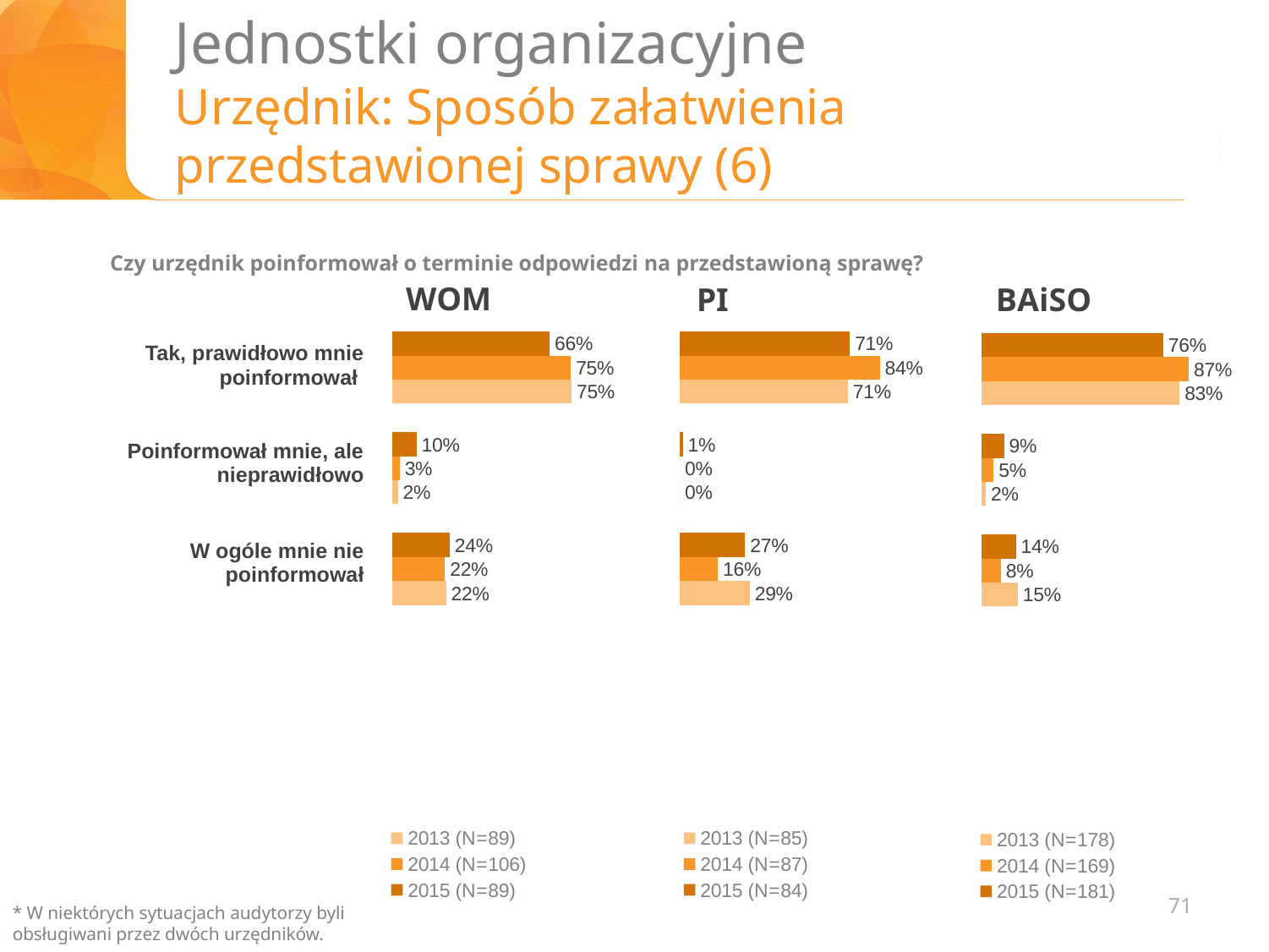
What sample size (N) is given for 2015 in the BAiSO chart legend? N=181 In the WOM chart, what is the 2015 value for "Tak, prawidłowo mnie poinformował"? 66% What type of chart is used for the PI data? Bar chart How many series does the legend of the WOM chart list? 3 In the PI chart, which is larger for "W ogóle mnie nie poinformował": the 2013 value or the 2015 value? 2013 In the BAiSO chart, what is the difference between the 2015 and 2013 values for "Poinformował mnie, ale nieprawidłowo"? 7 percentage points How many response categories are shown in each chart? 3 In the BAiSO chart, what is the 2013 value for "W ogóle mnie nie poinformował"? 15% In the PI chart, what is the 2014 value for "Tak, prawidłowo mnie poinformował"? 84% In the WOM chart, what is the difference between the 2014 and 2015 values for "Tak, prawidłowo mnie poinformował"? 9 percentage points In the PI chart, which year has the lowest value for "W ogóle mnie nie poinformował"? 2014 In the BAiSO chart, which year has the highest value for "Tak, prawidłowo mnie poinformował"? 2014